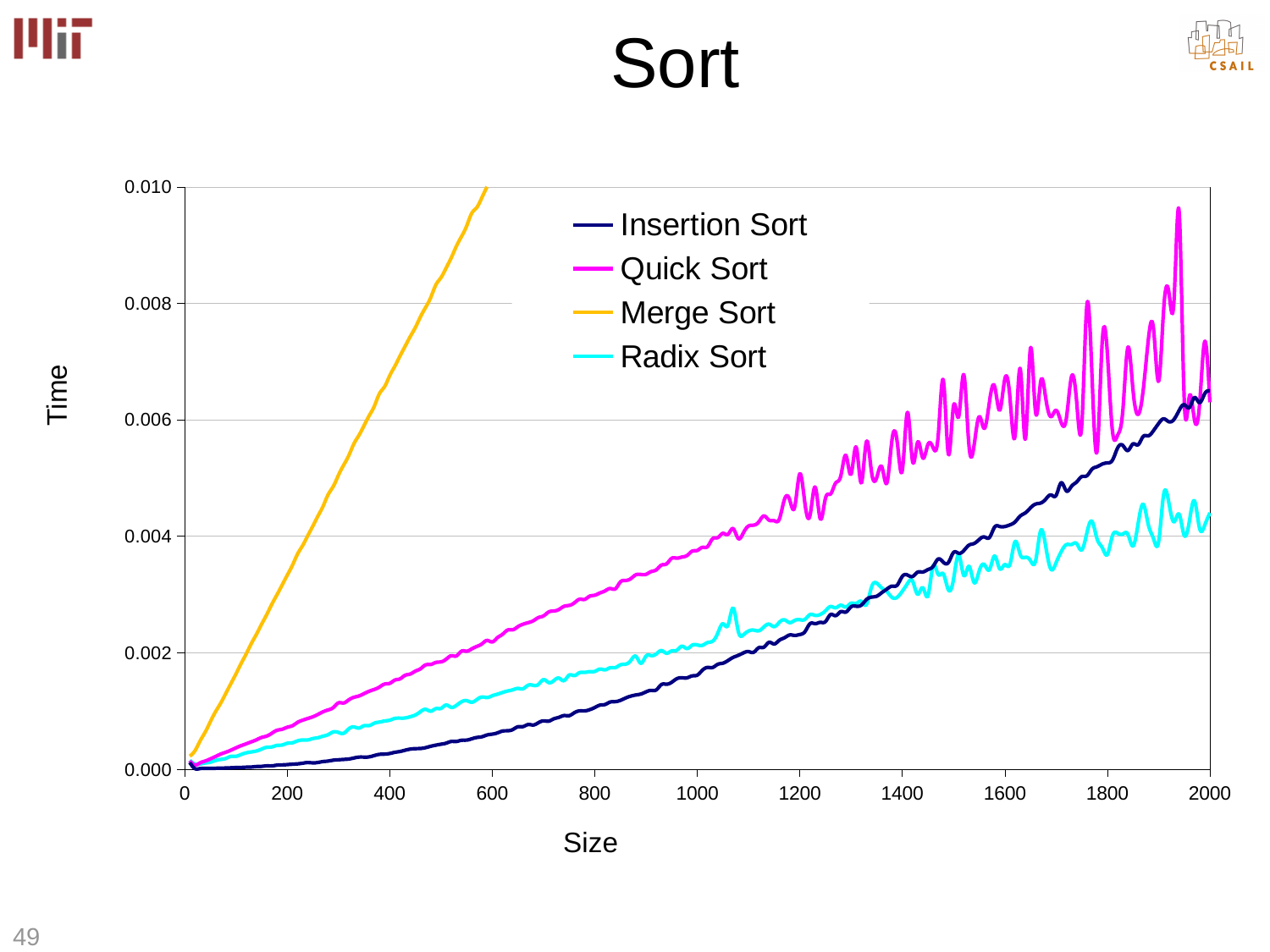
Is the time for Merge Sort at size 400 greater or less than 0.004? greater Which series has the lowest time at size 400? Insertion Sort What is the label of the y axis? Time Which series has the highest time at size 400? Merge Sort Is the time for Radix Sort at size 2000 greater or less than 0.006? less At size 1000, which has the larger time, Quick Sort or Insertion Sort? Quick Sort What kind of chart is shown on the slide? line chart How many series does the legend list? 4 What is the label of the x axis? Size Which series rises above the top of the y axis (0.010) before size 600? Merge Sort Does the time for Insertion Sort rise or fall as size increases? rise